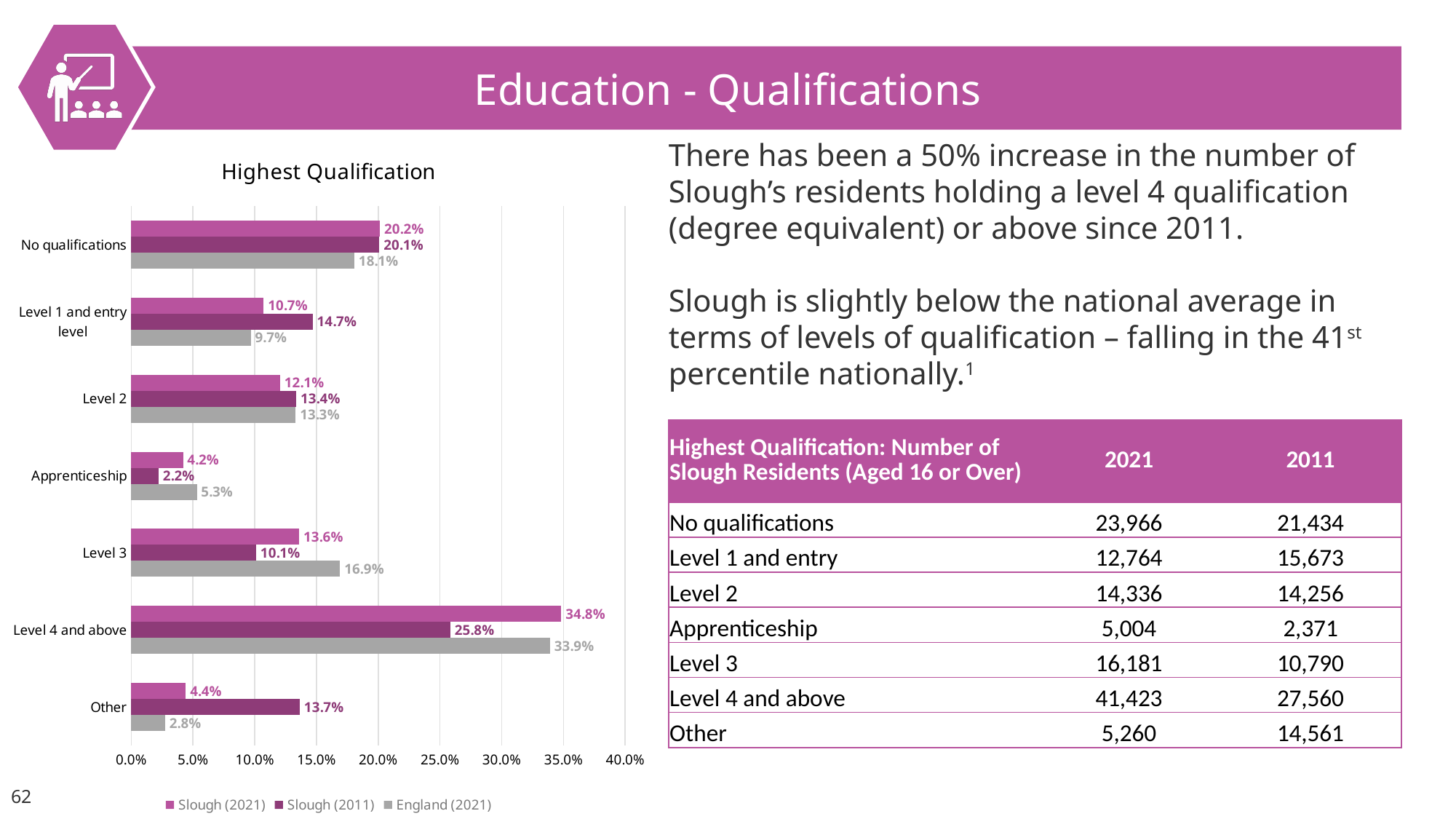
Which is larger for Level 3: the Slough (2021) value or the England (2021) value? England (2021) Is the Slough (2011) value for Other greater or less than 10.0%? greater What is the difference between the Slough (2021) and Slough (2011) values for Level 4 and above? 9.0% What is the title of the chart? Highest Qualification What is the Slough (2011) value for Apprenticeship? 2.2% Which category has the lowest England (2021) value? Other Which category has the highest Slough (2021) value? Level 4 and above How many series does the legend list? 3 How many qualification categories are shown on the chart? 7 What type of chart is shown? Bar chart What is the Slough (2021) value for Level 4 and above? 34.8% What is the England (2021) value for No qualifications? 18.1%